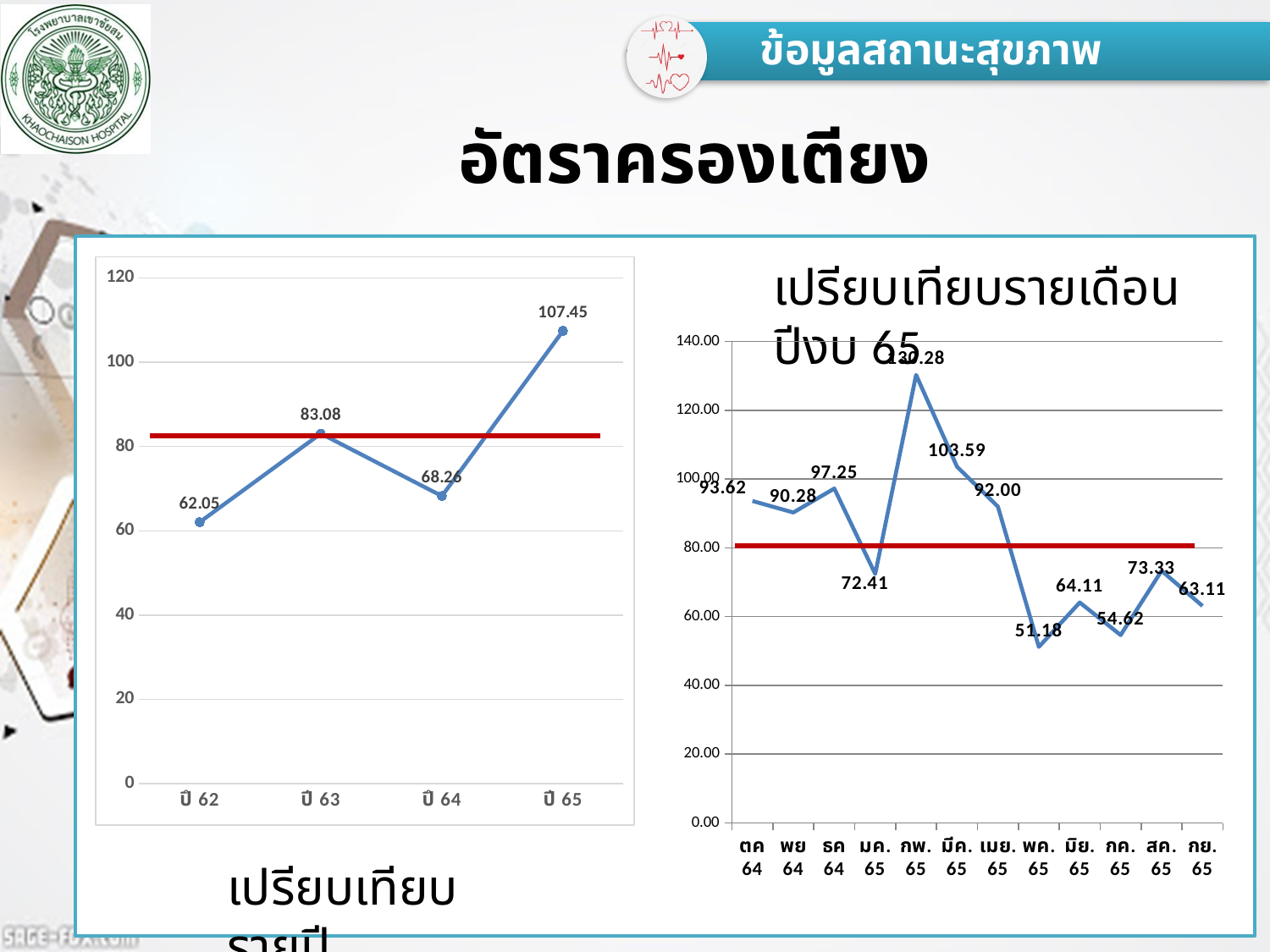
In the left chart (เปรียบเทียบรายปี), what is the value for ปี 62? 62.05 In the right chart (เปรียบเทียบรายเดือนปีงบ 65), which month has the lowest value? พค. 65 What kind of chart is the left chart (เปรียบเทียบรายปี)? Line chart In the left chart (เปรียบเทียบรายปี), what is the value for ปี 65? 107.45 In the right chart (เปรียบเทียบรายเดือนปีงบ 65), which is larger, the value for ธค 64 or the value for เมย. 65? ธค 64 In the right chart (เปรียบเทียบรายเดือนปีงบ 65), what is the value for มีค. 65? 103.59 In the left chart (เปรียบเทียบรายปี), which year has the lowest value? ปี 62 In the left chart (เปรียบเทียบรายปี), how many years are plotted? 4 In the left chart (เปรียบเทียบรายปี), what is the difference between the values for ปี 63 and ปี 64? 14.82 In the right chart (เปรียบเทียบรายเดือนปีงบ 65), how many months are plotted? 12 In the right chart (เปรียบเทียบรายเดือนปีงบ 65), what is the value for พค. 65? 51.18 In the right chart (เปรียบเทียบรายเดือนปีงบ 65), which month has the highest value? กพ. 65